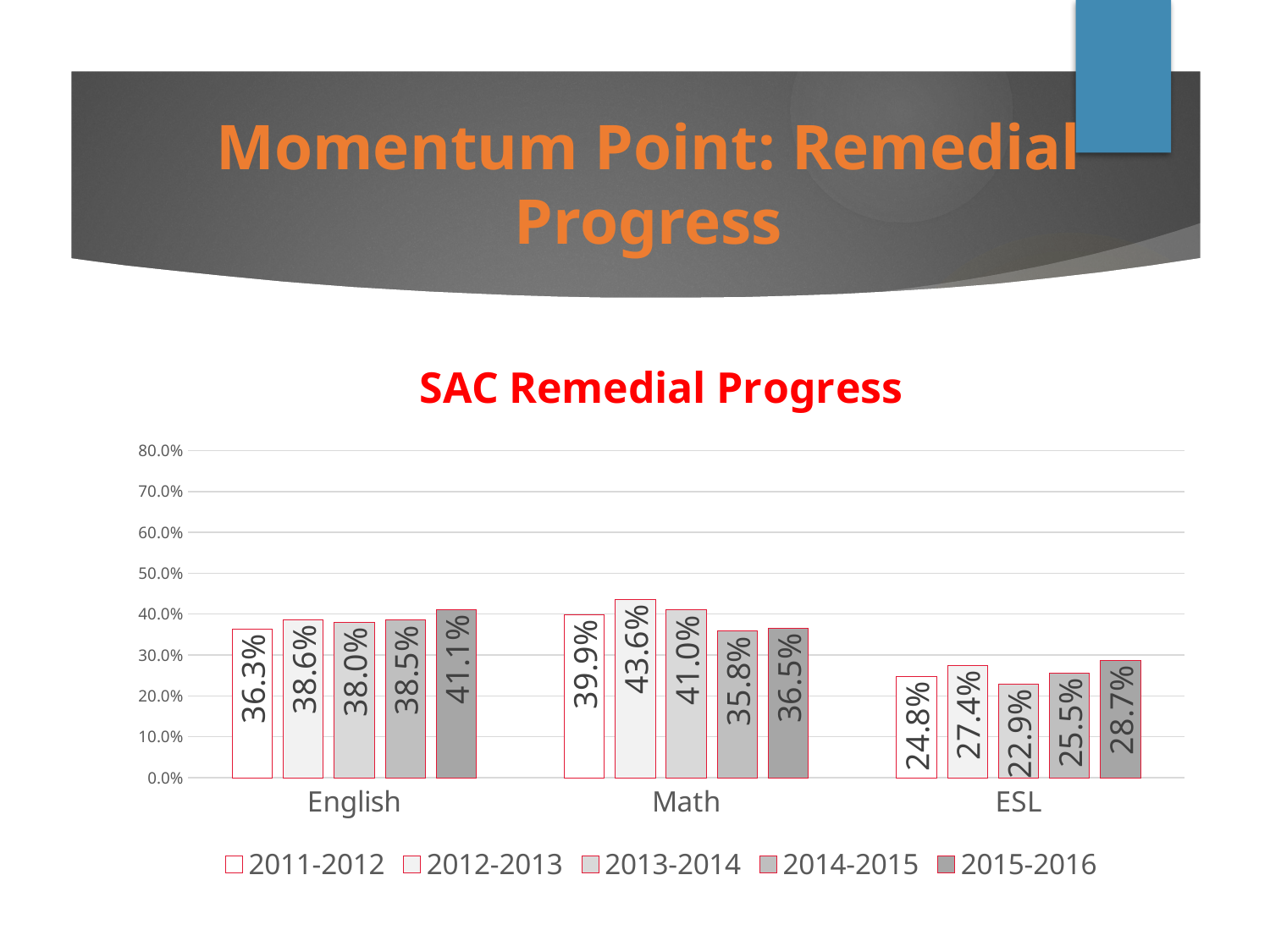
How many series does the legend list? 5 What is the value for ESL in 2013-2014? 22.9% Which is larger, the Math value for 2011-2012 or the Math value for 2014-2015? 2011-2012 What is the value for English in 2015-2016? 41.1% Which year has the highest value for Math? 2012-2013 Is the value for ESL in 2015-2016 greater or less than 30.0%? less How many categories are shown on the x axis? 3 Which year has the lowest value for ESL? 2013-2014 What is the title of the chart? SAC Remedial Progress What is the value for Math in 2012-2013? 43.6% What is the difference between the English values for 2015-2016 and 2011-2012? 4.8% What kind of chart is shown? bar chart